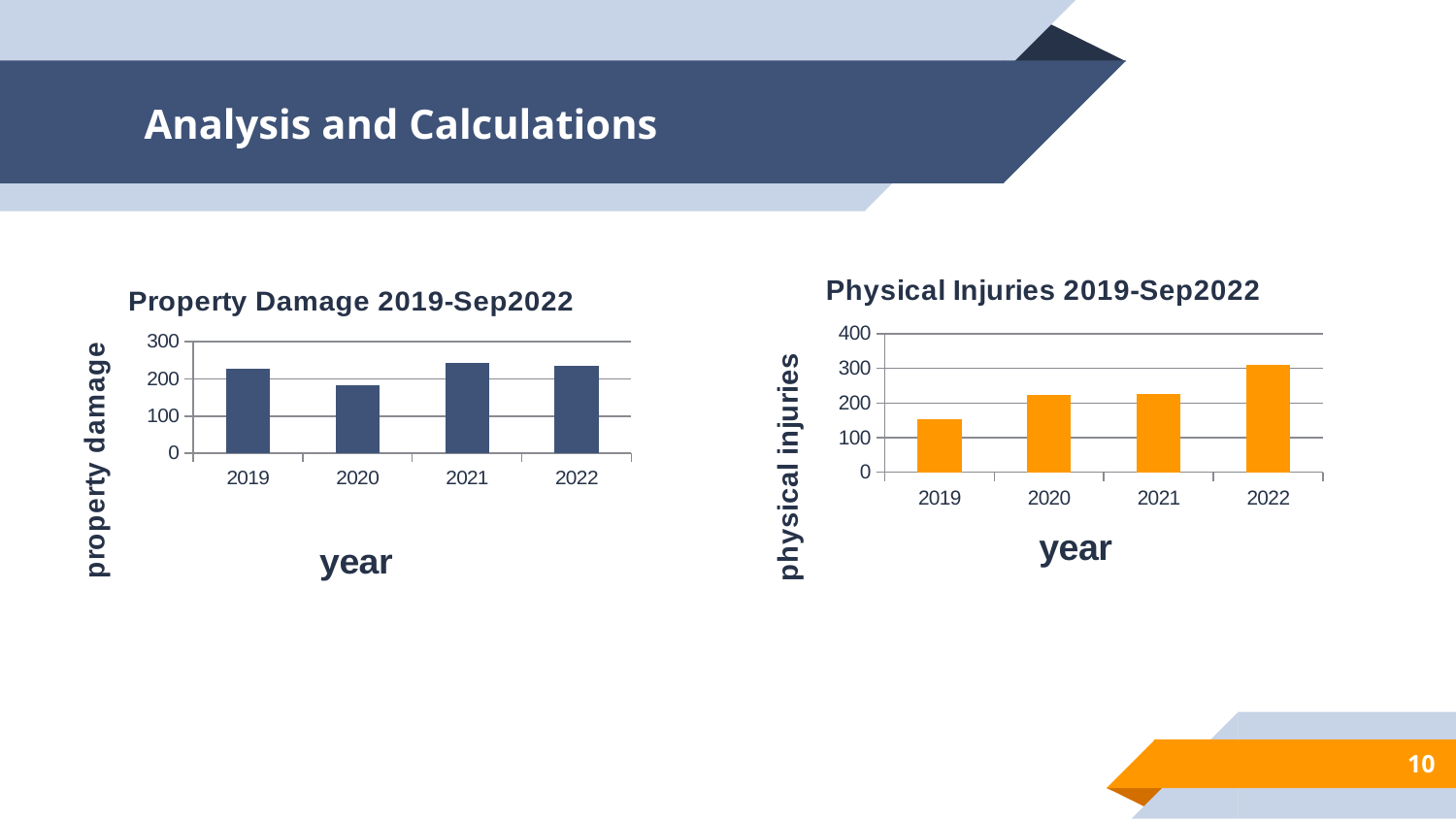
What is the label on the y axis of the Physical Injuries 2019-Sep2022 chart? physical injuries In the Physical Injuries 2019-Sep2022 chart, is the value for 2019 greater or less than 200? less In the Property Damage 2019-Sep2022 chart, is the value for 2020 greater or less than 200? less In the Physical Injuries 2019-Sep2022 chart, which year has the lowest number of physical injuries? 2019 How many years are shown on the x axis of the Physical Injuries 2019-Sep2022 chart? 4 In the Property Damage 2019-Sep2022 chart, which year has the larger value, 2019 or 2020? 2019 What type of chart is the Property Damage 2019-Sep2022 chart? bar chart In the Property Damage 2019-Sep2022 chart, is the value for 2021 greater or less than 200? greater In the Physical Injuries 2019-Sep2022 chart, which year has the highest number of physical injuries? 2022 In the Physical Injuries 2019-Sep2022 chart, which year has the larger value, 2019 or 2022? 2022 In the Property Damage 2019-Sep2022 chart, which year has the lowest property damage? 2020